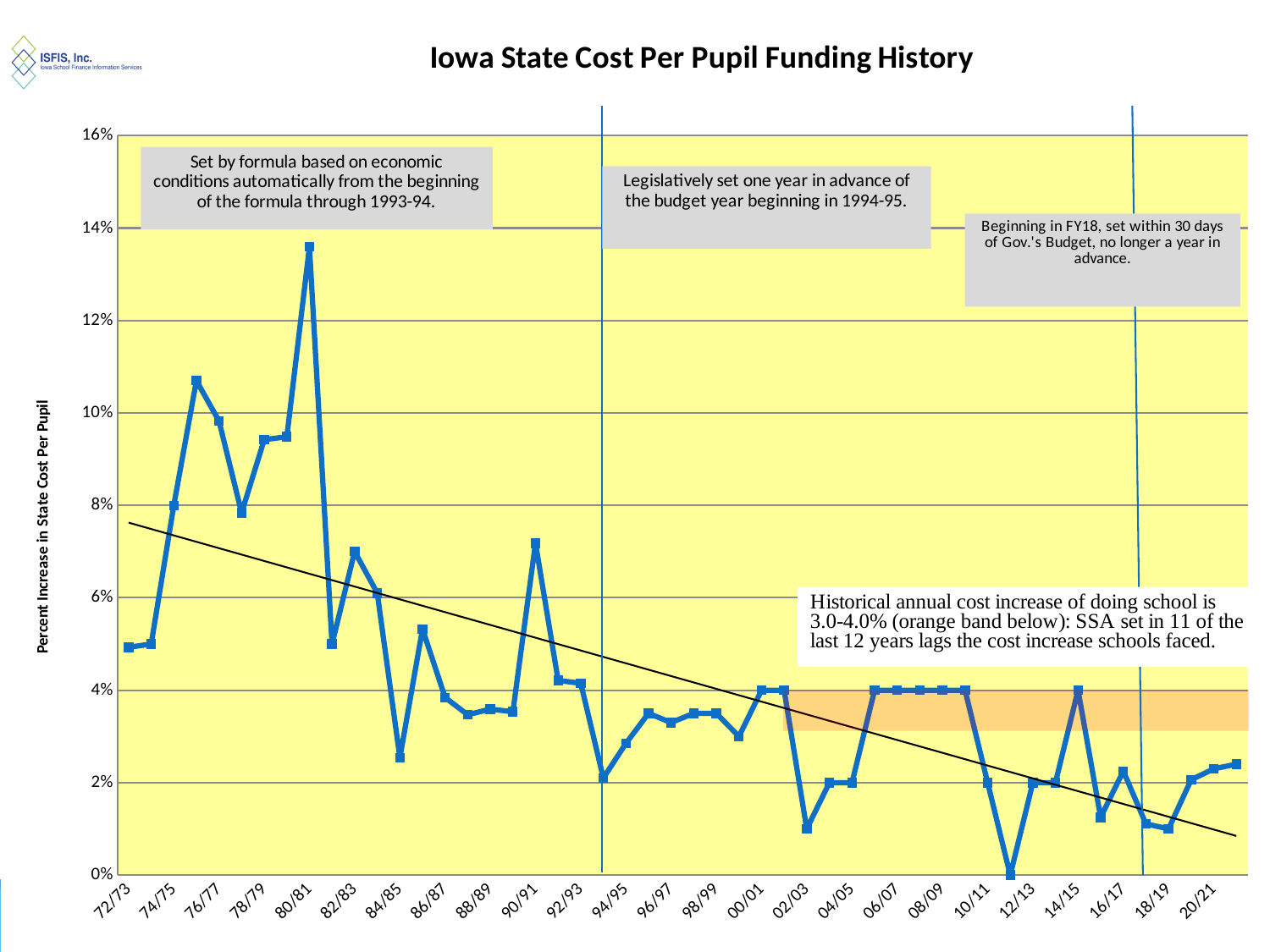
Which year on the x axis has the lowest percent increase in state cost per pupil? 11/12 What is the percent increase in state cost per pupil for 00/01? 4% What is the label on the vertical axis of the chart? Percent Increase in State Cost Per Pupil What is the percent increase in state cost per pupil for 12/13? 2% Is the value for 76/77 greater or less than 8%? greater Overall, do the values rise or fall from 72/73 to 20/21? fall Which year on the x axis has the highest percent increase in state cost per pupil? 80/81 Which year has the larger percent increase, 80/81 or 90/91? 80/81 Is the value for 84/85 greater or less than 4%? less What is the title of the chart? Iowa State Cost Per Pupil Funding History What kind of chart is shown on the slide? line chart Is the value for 02/03 greater or less than 2%? less